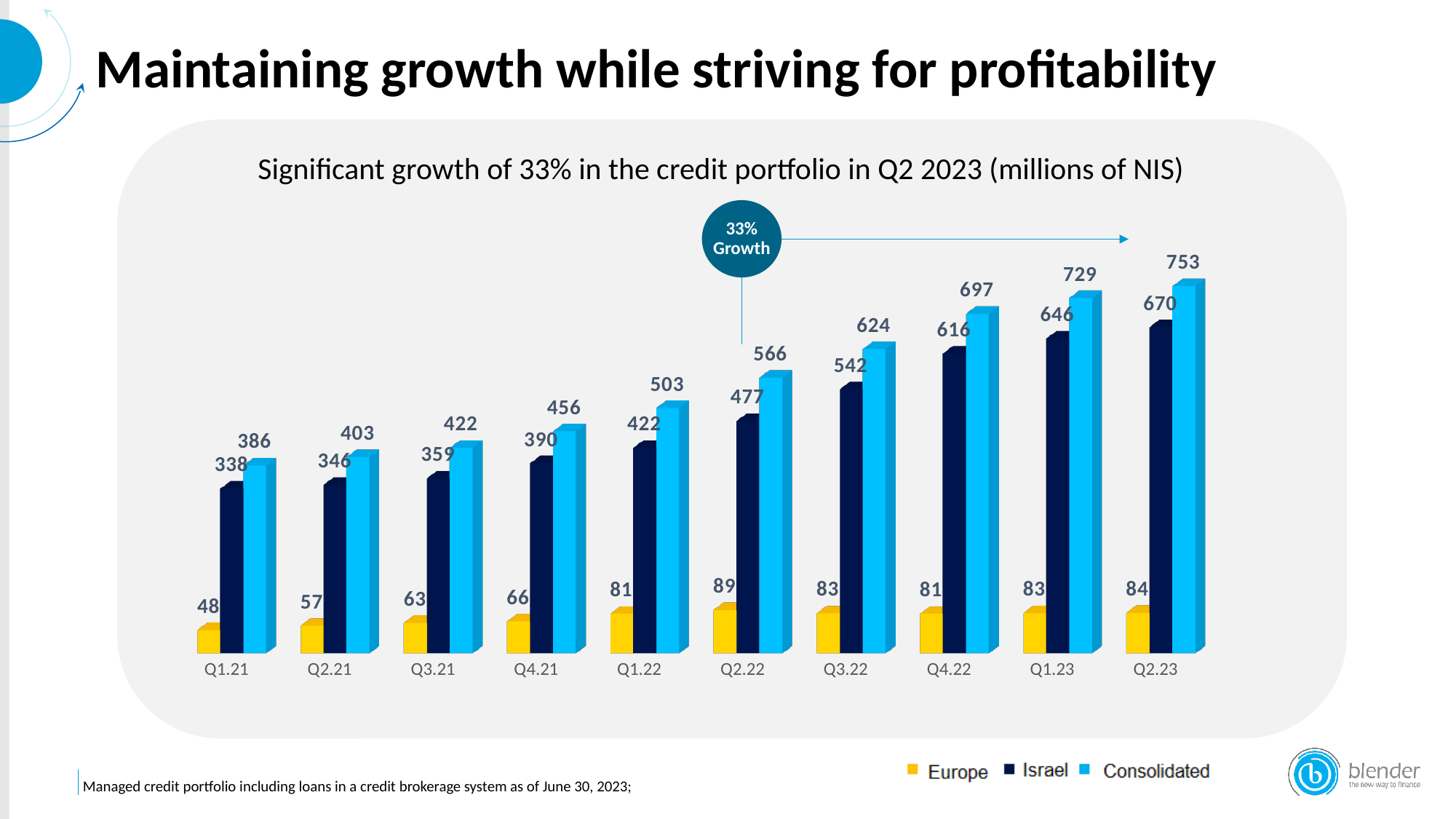
What is the Israel value for Q1.21? 338 What is the Europe value for Q2.22? 89 Which quarter has the highest Consolidated value? Q2.23 Which quarter has the lowest Europe value? Q1.21 What kind of chart is shown on the slide? Bar chart What is the difference between the Consolidated values for Q2.23 and Q2.22? 187 How many quarters are shown on the x axis? 10 Do the Consolidated values rise or fall from Q1.21 to Q2.23? Rise What growth percentage is highlighted in the circle above the chart? 33% Growth What is the Consolidated value for Q2.23? 753 How many series does the legend list? 3 Which is larger, the Israel value for Q4.22 or the Israel value for Q1.23? Q1.23